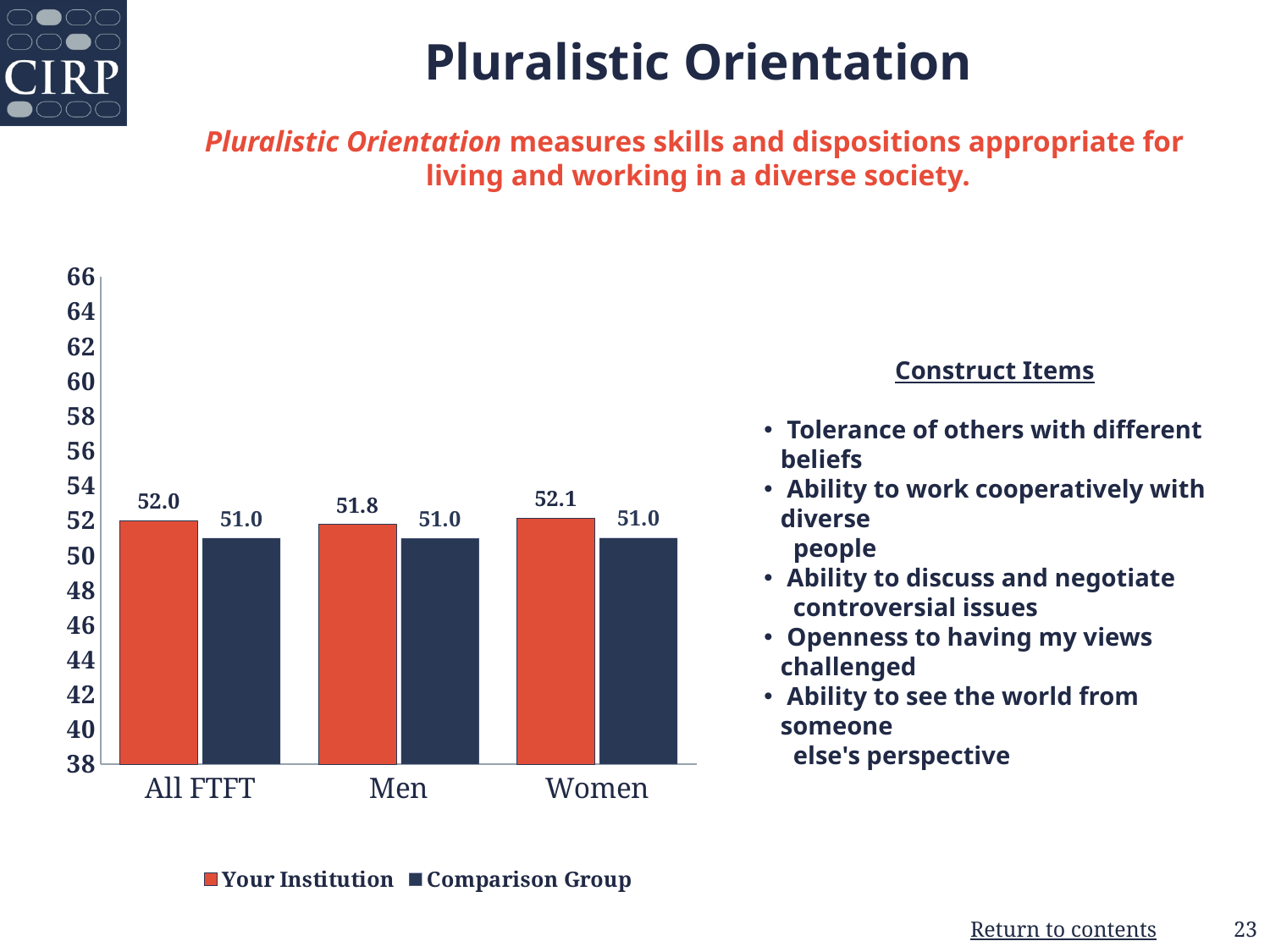
What is the Comparison Group value for Men? 51.0 What is the Your Institution value for All FTFT? 52.0 What is the difference between the Your Institution and Comparison Group values for All FTFT? 1.0 How many series does the legend list? 2 How many categories are shown on the x axis? 3 Which series is shown in dark navy in the legend? Comparison Group Which is larger for Men: the Your Institution value or the Comparison Group value? Your Institution What kind of chart is shown on the slide? Bar chart What is the Your Institution value for Women? 52.1 What is the Your Institution value for Men? 51.8 What is the difference between the Your Institution and Comparison Group values for Women? 1.1 Is the Your Institution value for Women greater or less than 50? greater